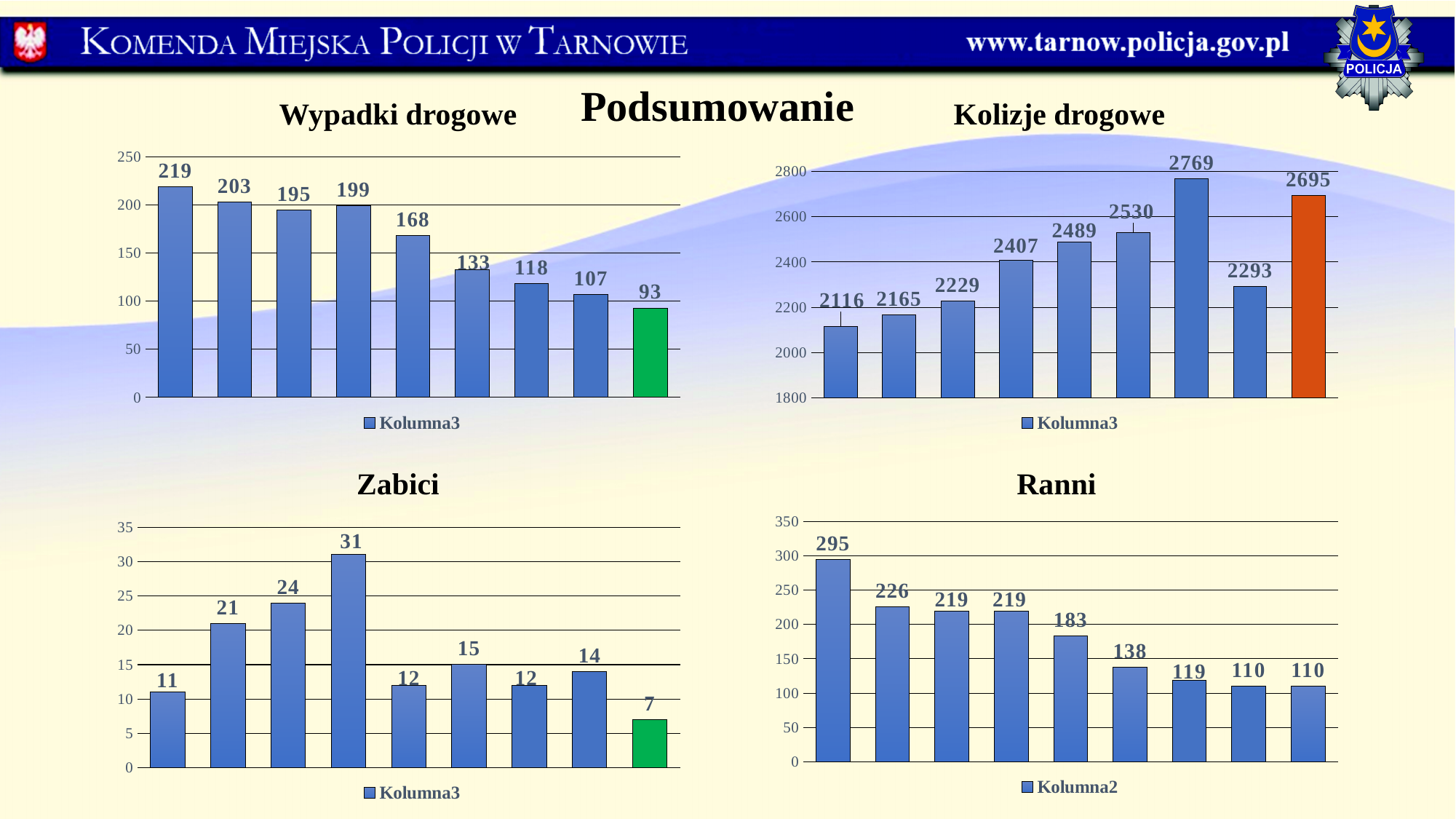
In the 'Wypadki drogowe' chart, what is the value of the green (last) bar? 93 In the 'Ranni' chart, what is the value of the first bar? 295 What type of chart is the 'Ranni' chart? Bar chart What legend entry is shown under the 'Ranni' chart? Kolumna2 In the 'Ranni' chart, what is the difference between the first bar (295) and the last bar (110)? 185 In the 'Zabici' chart, what is the highest value shown? 31 In the 'Zabici' chart, what is the lowest value shown? 7 How many bars are plotted in the 'Wypadki drogowe' chart? 9 In the 'Kolizje drogowe' chart, which bar has the highest value, and what is it? The seventh bar, 2769 In the 'Wypadki drogowe' chart, what is the value of the first (leftmost) bar? 219 In the 'Kolizje drogowe' chart, what is the value of the orange (last) bar? 2695 In the 'Kolizje drogowe' chart, what is the difference between the first bar (2116) and the last bar (2695)? 579